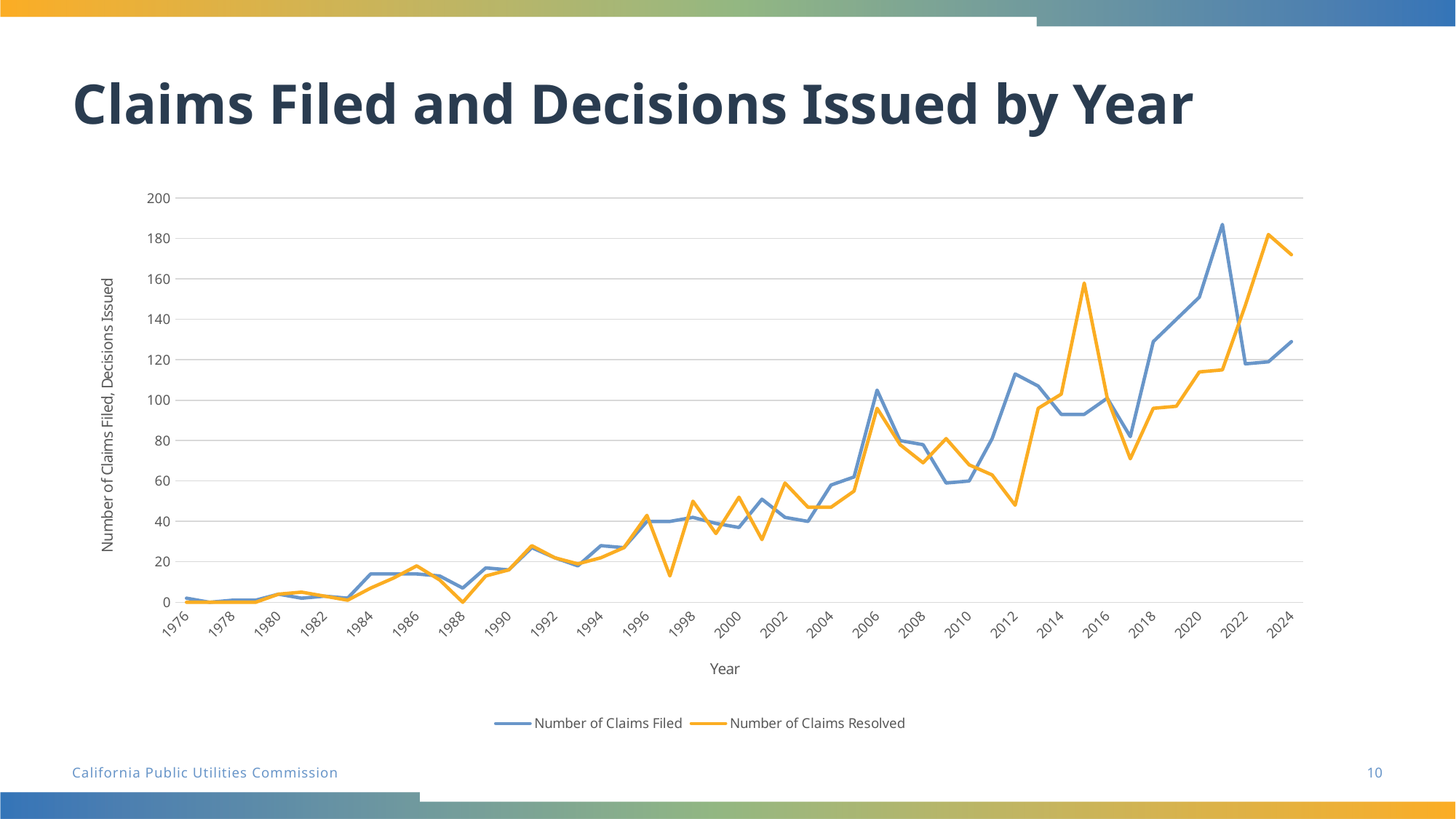
What kind of chart is shown on the slide? line chart How many year labels are shown on the x axis? 25 In 2012, which is larger: Number of Claims Filed or Number of Claims Resolved? Number of Claims Filed Is the value for Number of Claims Resolved in 2012 greater or less than 60? less Is the value for Number of Claims Filed in 2024 greater or less than 120? greater What is the title of the chart's vertical axis? Number of Claims Filed, Decisions Issued What are the two series named in the legend? Number of Claims Filed and Number of Claims Resolved Is the value for Number of Claims Filed in 1988 greater or less than 20? less How many series does the legend list? 2 In 2024, which is larger: Number of Claims Filed or Number of Claims Resolved? Number of Claims Resolved Overall, do the values for Number of Claims Filed rise or fall from 1976 to 2024? rise